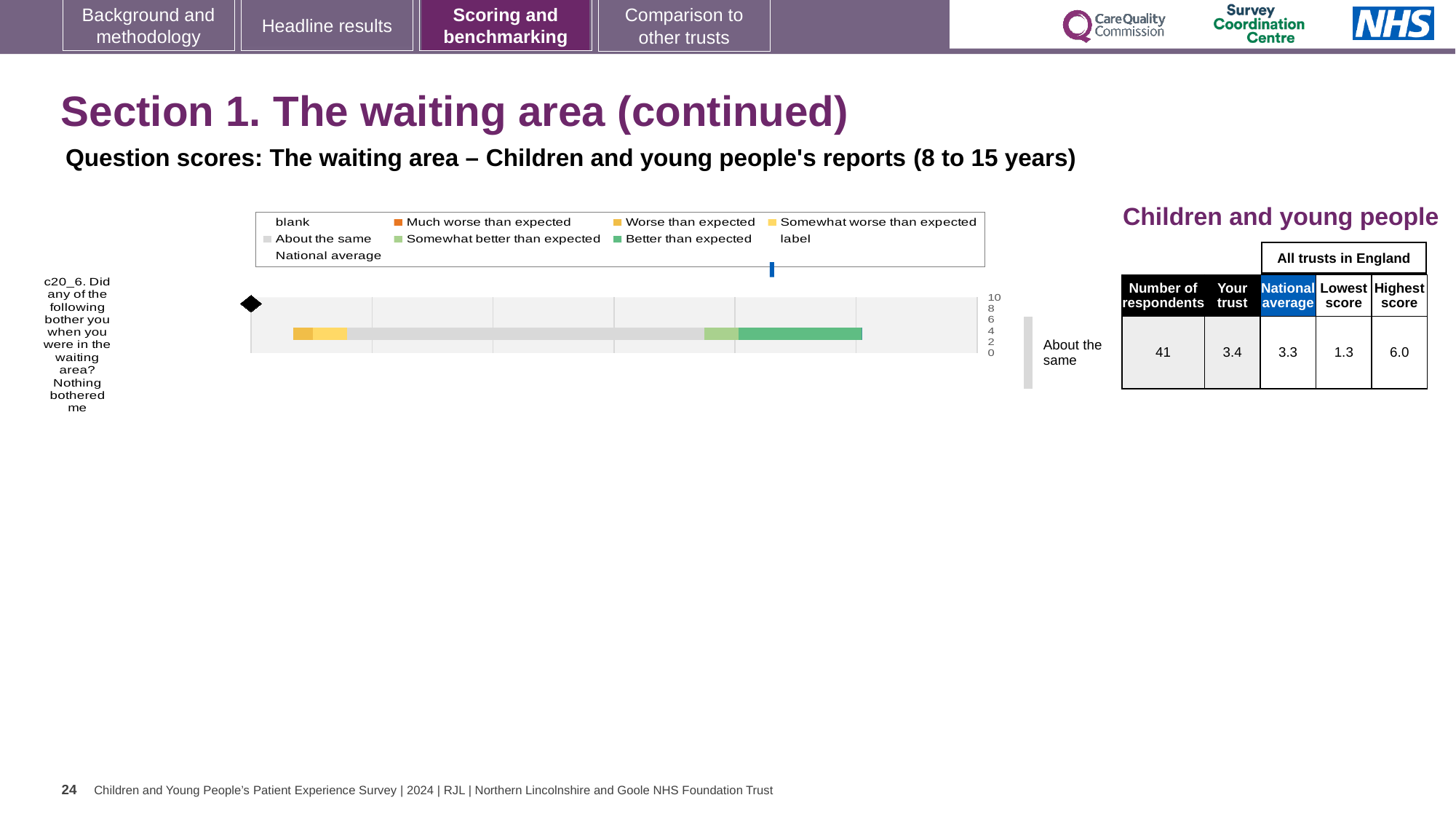
In the table beside the chart, which is larger for question c20_6: the 'Your trust' score or the national average? Your trust In the table beside the chart, what is the highest score among all trusts in England for question c20_6? 6.0 In the table beside the chart, what is the 'Your trust' score for question c20_6? 3.4 What rating label is shown to the right of the bar for question c20_6? About the same Which legend entry is shown in dark green? Better than expected How many question categories are plotted in the chart? 1 In the table beside the chart, what is the lowest score among all trusts in England for question c20_6? 1.3 In the table beside the chart, what is the difference between the highest score and the lowest score for question c20_6? 4.7 How many entries does the chart's legend list? 9 What kind of chart is shown on the slide? bar chart In the table beside the chart, how many respondents answered question c20_6? 41 In the table beside the chart, what is the national average score for question c20_6? 3.3